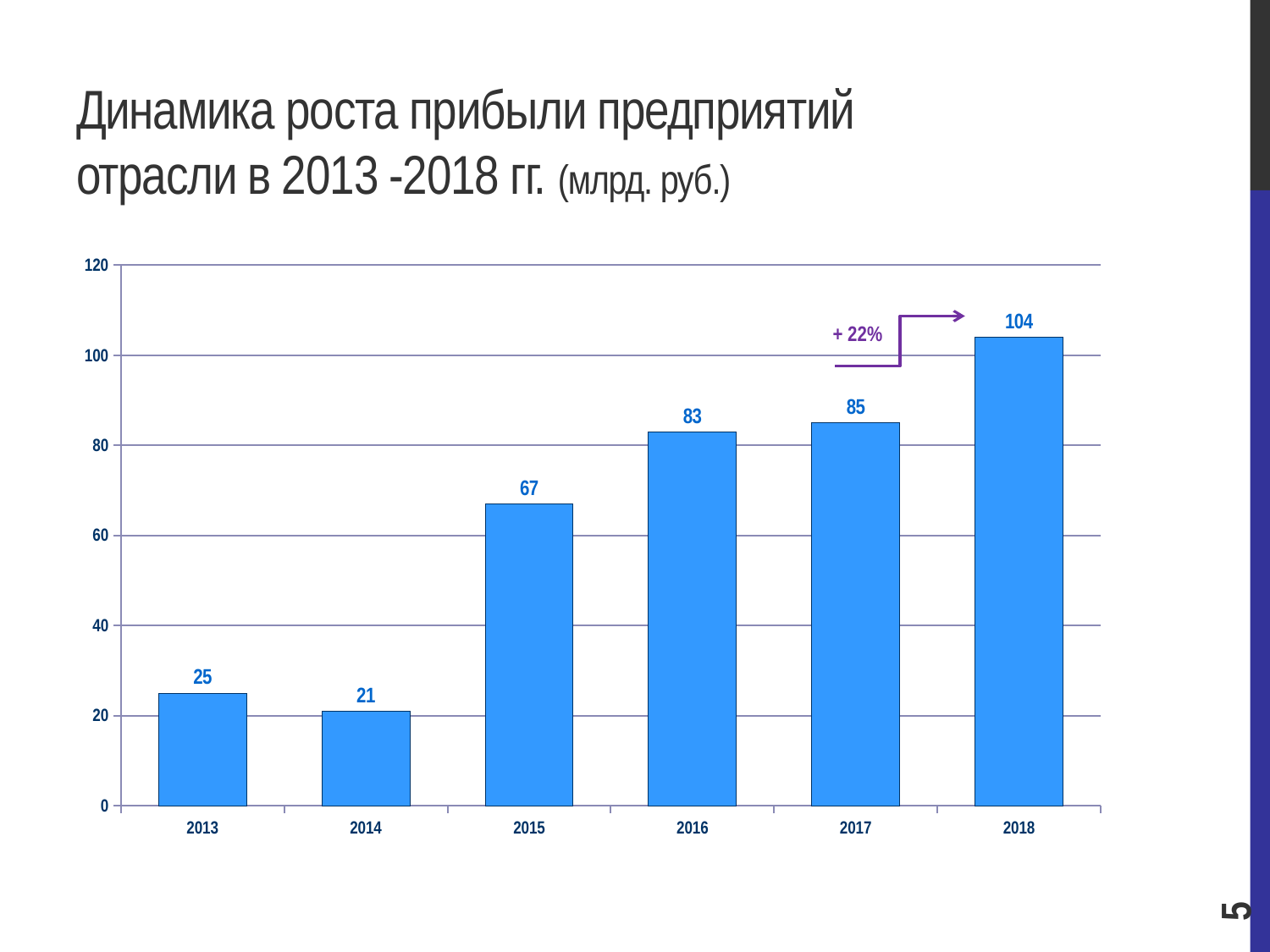
What percentage change is annotated between 2017 and 2018? + 22% Which year has the highest value? 2018 Which year has the lowest value? 2014 What is the difference between the values for 2018 and 2017? 19 What is the value for 2016? 83 What is the value for 2013? 25 What is the value for 2018? 104 How many years are shown on the x axis? 6 What is the difference between the values for 2015 and 2014? 46 Is the value for 2015 greater or less than 60? greater What kind of chart is shown on the slide? bar chart Which is larger, the value for 2016 or the value for 2017? 2017